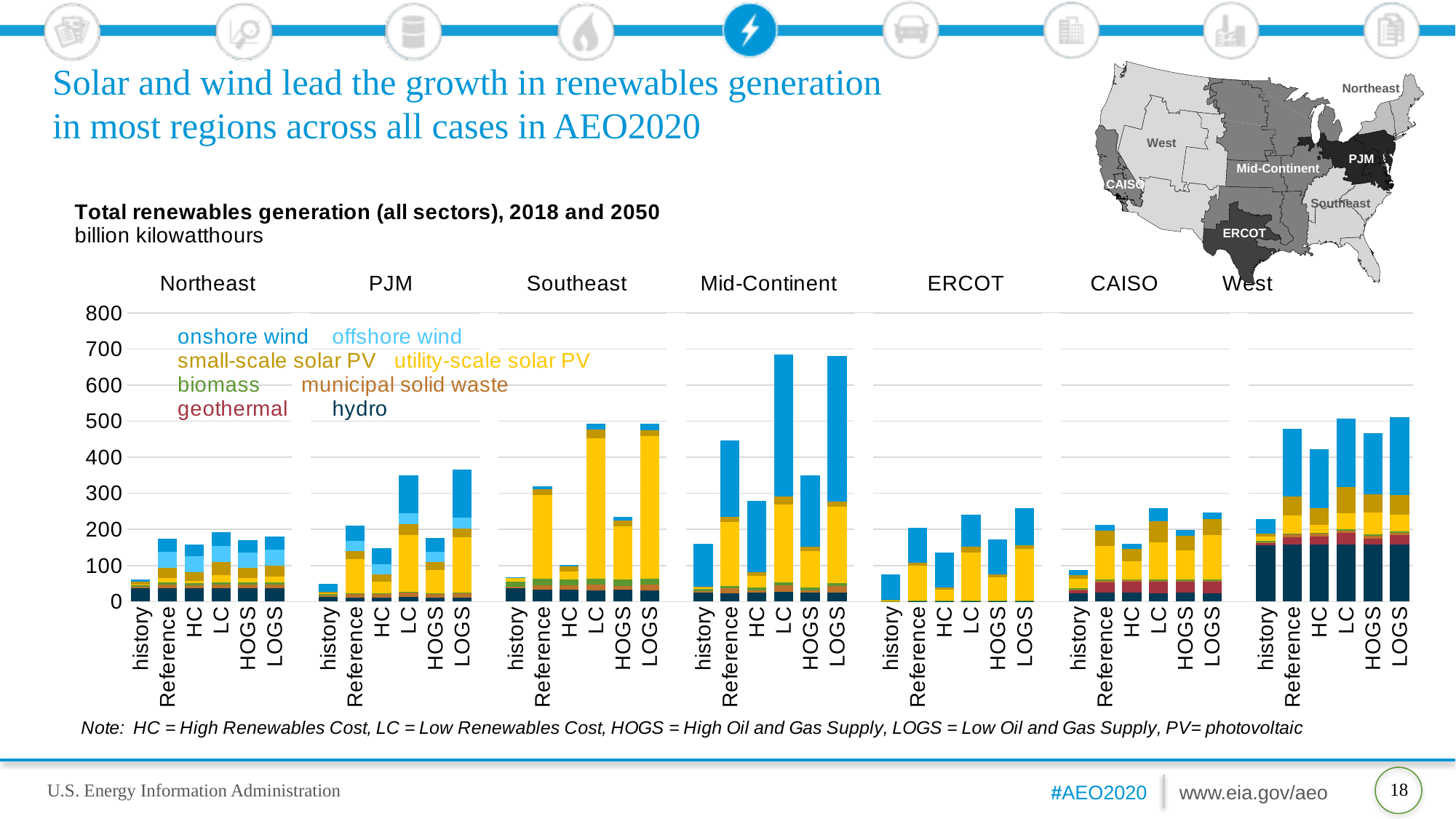
Is the total for the Mid-Continent LC case greater or less than 600 billion kilowatthours? greater In what units is the chart's data expressed? billion kilowatthours Within the PJM group, which case has the lowest total renewables generation? history How many regions are shown as separate groups in the chart? 7 Is the total for the PJM LC case greater or less than 300 billion kilowatthours? greater What kind of chart is shown on the slide? stacked bar chart Which region and case has the tallest bar in the chart? Mid-Continent, LC Is the total for the ERCOT history bar greater or less than 100 billion kilowatthours? less How many series does the chart's legend list? 8 Within the ERCOT group, which case has the highest total renewables generation? LOGS How many bars (cases) are plotted for each region? 6 Which is larger, the Reference case total for Southeast or the Reference case total for Northeast? Southeast